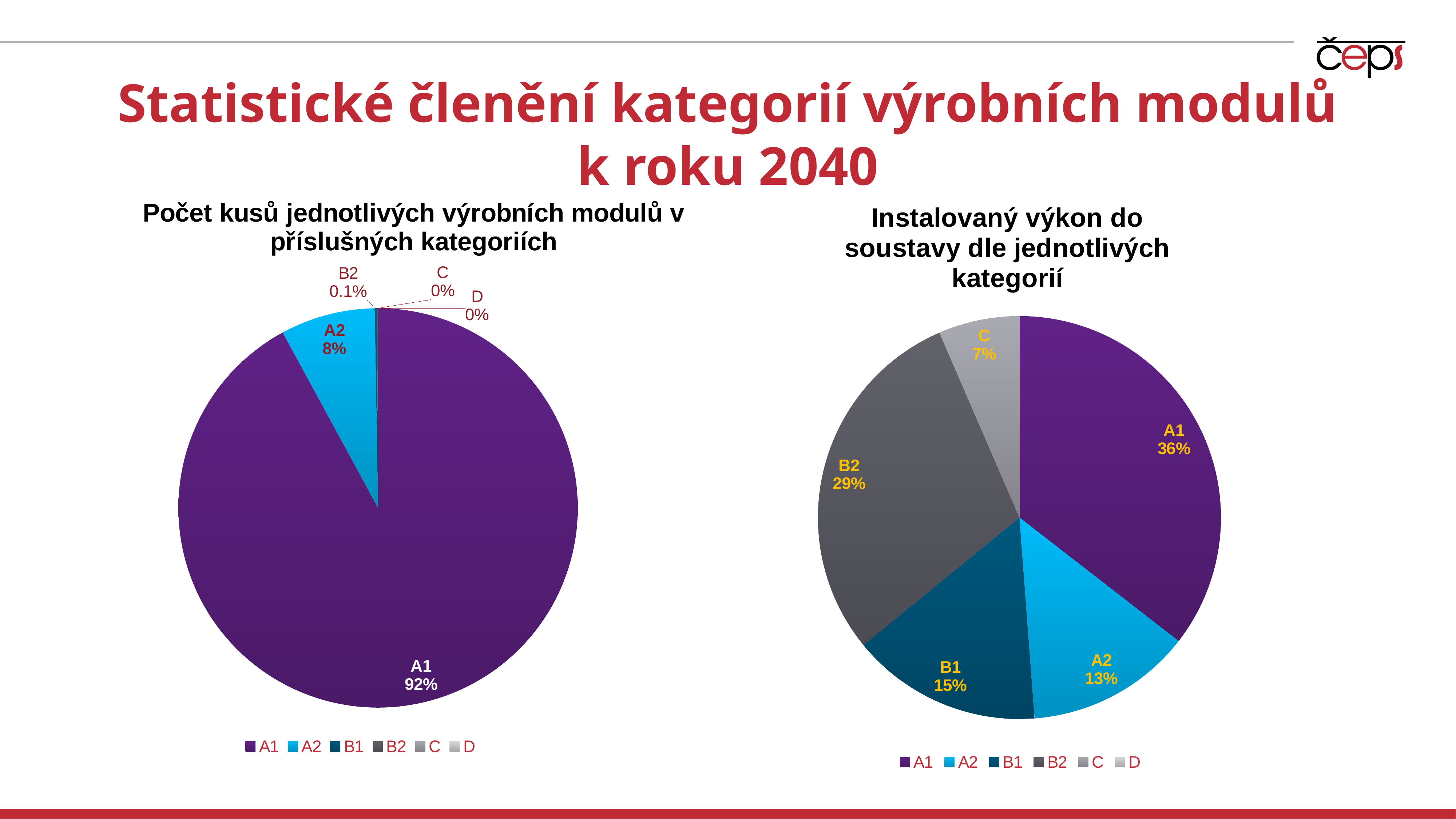
In the right chart (Instalovaný výkon do soustavy dle jednotlivých kategorií), what share does A2 have? 13% How many entries does the legend of the left chart (Počet kusů jednotlivých výrobních modulů v příslušných kategoriích) list? 6 In the right chart (Instalovaný výkon do soustavy dle jednotlivých kategorií), which category has the largest slice? A1 In the right chart (Instalovaný výkon do soustavy dle jednotlivých kategorií), what share does B2 have? 29% In the right chart (Instalovaný výkon do soustavy dle jednotlivých kategorií), what share does C have? 7% What kind of chart is the right chart (Instalovaný výkon do soustavy dle jednotlivých kategorií)? Pie chart In the right chart (Instalovaný výkon do soustavy dle jednotlivých kategorií), which is larger, B1 or A2? B1 In the right chart (Instalovaný výkon do soustavy dle jednotlivých kategorií), what is the difference in percentage points between A1 and B2? 7 In the left chart (Počet kusů jednotlivých výrobních modulů v příslušných kategoriích), which category has the largest slice? A1 In the left chart (Počet kusů jednotlivých výrobních modulů v příslušných kategoriích), what share is labelled for B2? 0.1%